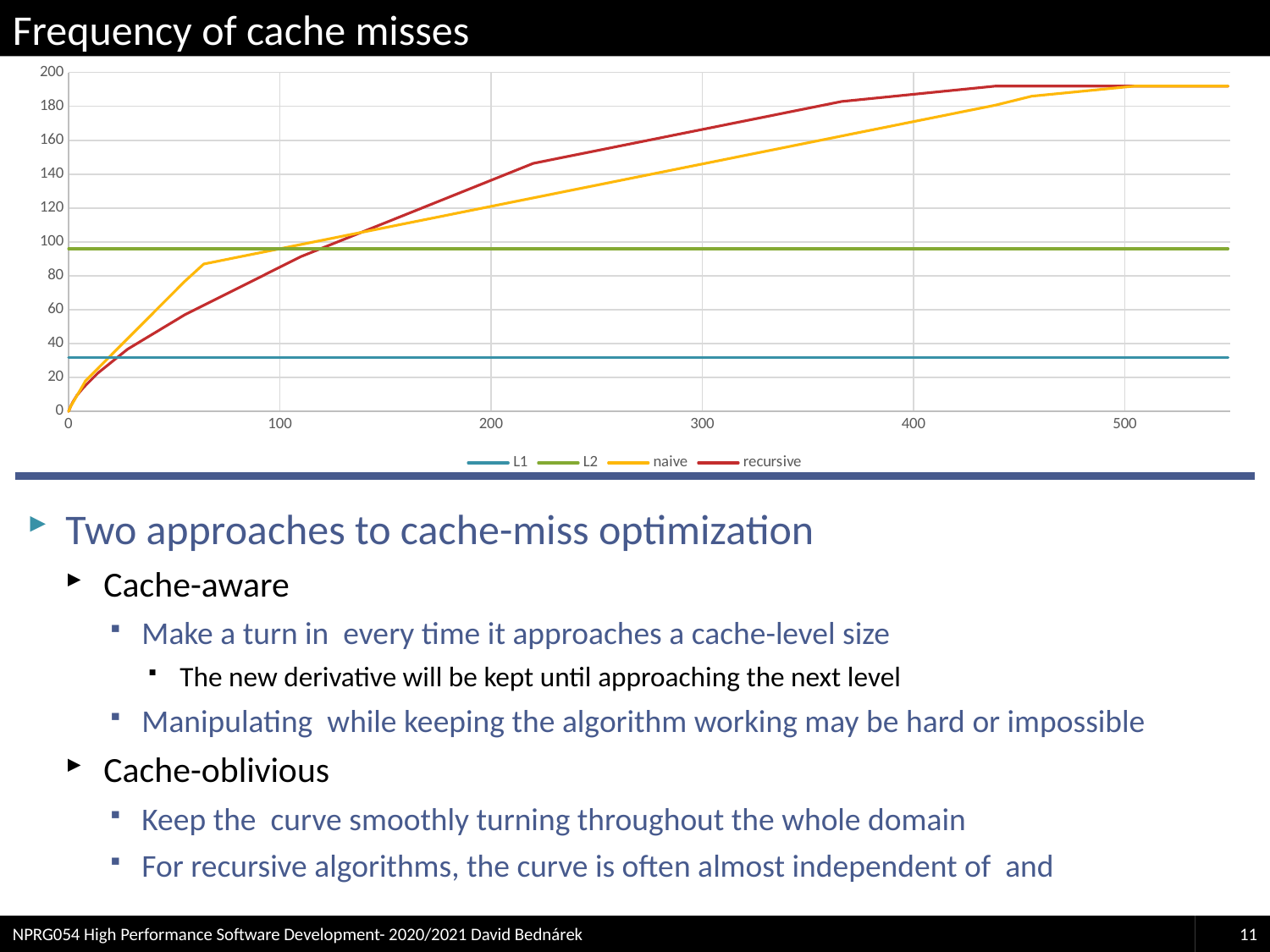
What kind of chart is shown on the slide? line chart Is the value of the recursive series at x = 100 greater or less than 100? less Is the value of the naive series at x = 400 greater or less than 160? greater At x = 300, which series has the higher value, naive or recursive? recursive Is the value of the L1 line greater or less than 40? less Which of the two horizontal lines, L1 or L2, is at the higher value? L2 What is the title of the chart? Frequency of cache misses What are the series names listed in the legend? L1, L2, naive, recursive Does the naive series rise or fall as x increases? rise How many series does the legend list? 4